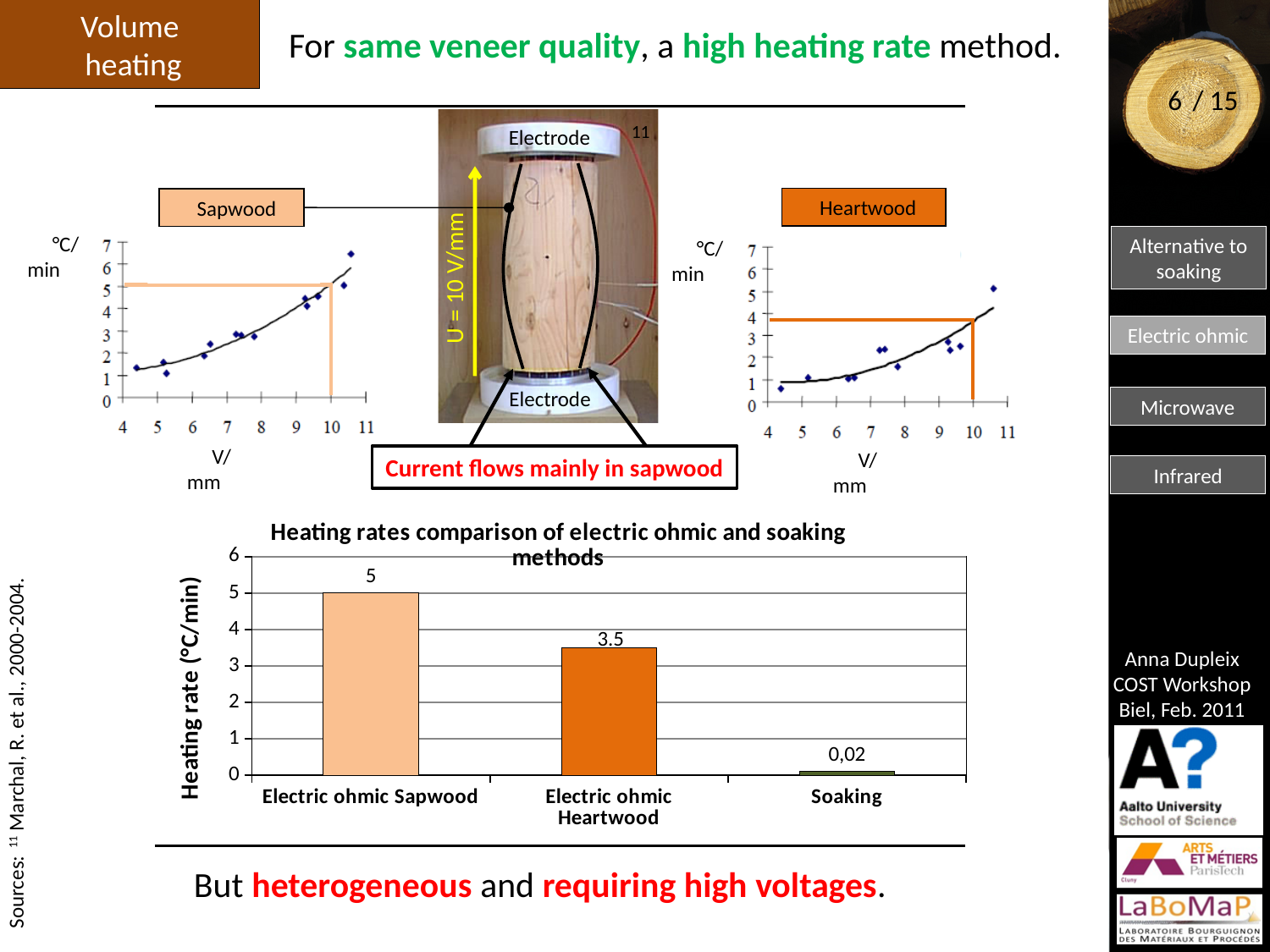
In the chart titled 'Heating rates comparison of electric ohmic and soaking methods', which has a larger heating rate, Electric ohmic Heartwood or Soaking? Electric ohmic Heartwood In the chart titled 'Heating rates comparison of electric ohmic and soaking methods', which method has the lowest heating rate? Soaking In the chart titled 'Heating rates comparison of electric ohmic and soaking methods', what is the heating rate for Electric ohmic Heartwood? 3.5 In the Heartwood chart at the top right of the slide, is the heating rate at 10 V/mm greater or less than 5 °C/min? less What kind of chart is the chart titled 'Heating rates comparison of electric ohmic and soaking methods'? bar chart In the Sapwood chart at the top left of the slide, is the heating rate at 10 V/mm greater or less than 4 °C/min? greater In the chart titled 'Heating rates comparison of electric ohmic and soaking methods', what is the heating rate for Soaking? 0,02 In the chart titled 'Heating rates comparison of electric ohmic and soaking methods', what is the difference in heating rate between Electric ohmic Sapwood and Electric ohmic Heartwood? 1.5 In the chart titled 'Heating rates comparison of electric ohmic and soaking methods', what is the heating rate for Electric ohmic Sapwood? 5 In the chart titled 'Heating rates comparison of electric ohmic and soaking methods', how many methods are compared? 3 In the chart titled 'Heating rates comparison of electric ohmic and soaking methods', what is the label of the vertical axis? Heating rate (°C/min) In the chart titled 'Heating rates comparison of electric ohmic and soaking methods', which method has the highest heating rate? Electric ohmic Sapwood